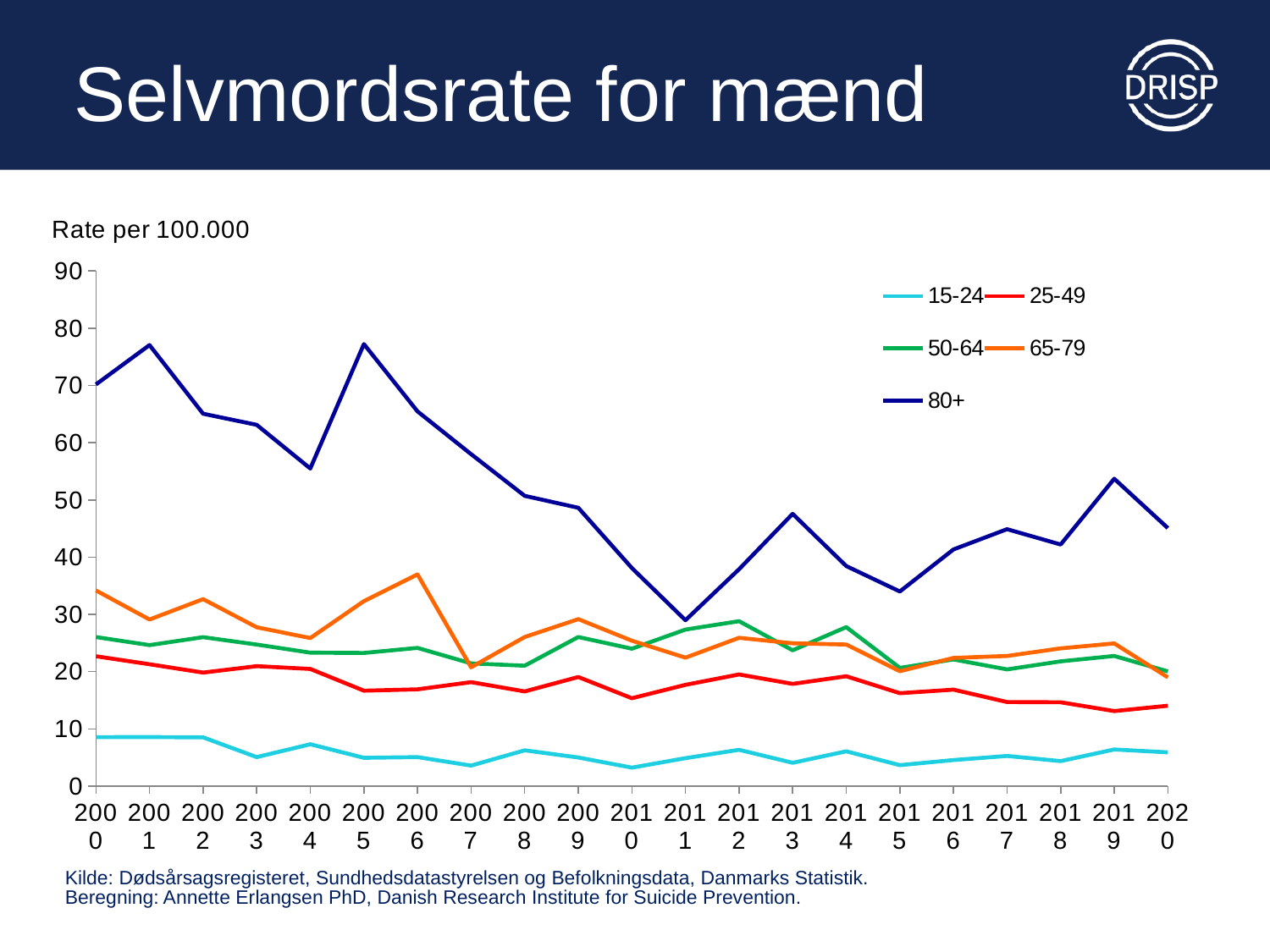
How many series does the legend list? 5 Is the value for the 80+ group in 2015 greater or less than 40? less Is the value for the 80+ group in 2001 greater or less than 70? greater What kind of chart is shown on the slide? line chart Which age group has the highest suicide rate across the whole period? 80+ Does the rate for the 80+ group rise or fall overall from 2000 to 2011? fall Which age group has the lowest suicide rate across the whole period? 15-24 How many years are plotted along the x axis? 21 Is the value for the 25-49 group in 2019 greater or less than 20? less In 2006, which is larger: the value for 65-79 or the value for 25-49? 65-79 What is the title of the chart on the slide? Selvmordsrate for mænd